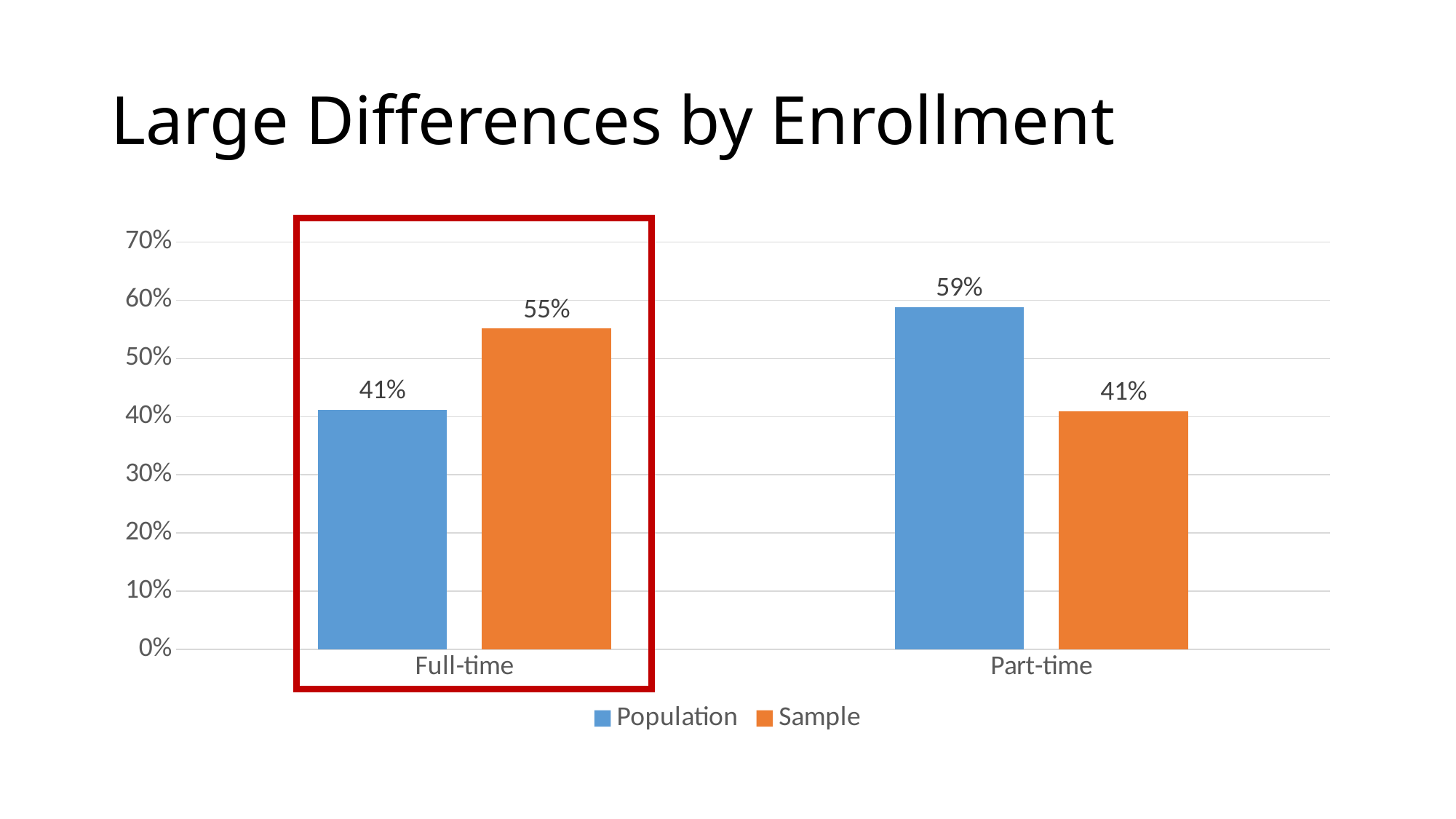
What is the Sample value for Full-time? 55% How many series does the legend list? 2 What is the Population value for Part-time? 59% For Part-time, which is larger: Population or Sample? Population What kind of chart is shown on the slide? Bar chart What is the Sample value for Part-time? 41% What is the difference between the Sample and Population values for Full-time? 14% How many categories are shown on the x axis? 2 Which category has the lowest Sample value? Part-time Which category has the highest Population value? Part-time What is the difference between the Population and Sample values for Part-time? 18% What is the Population value for Full-time? 41%